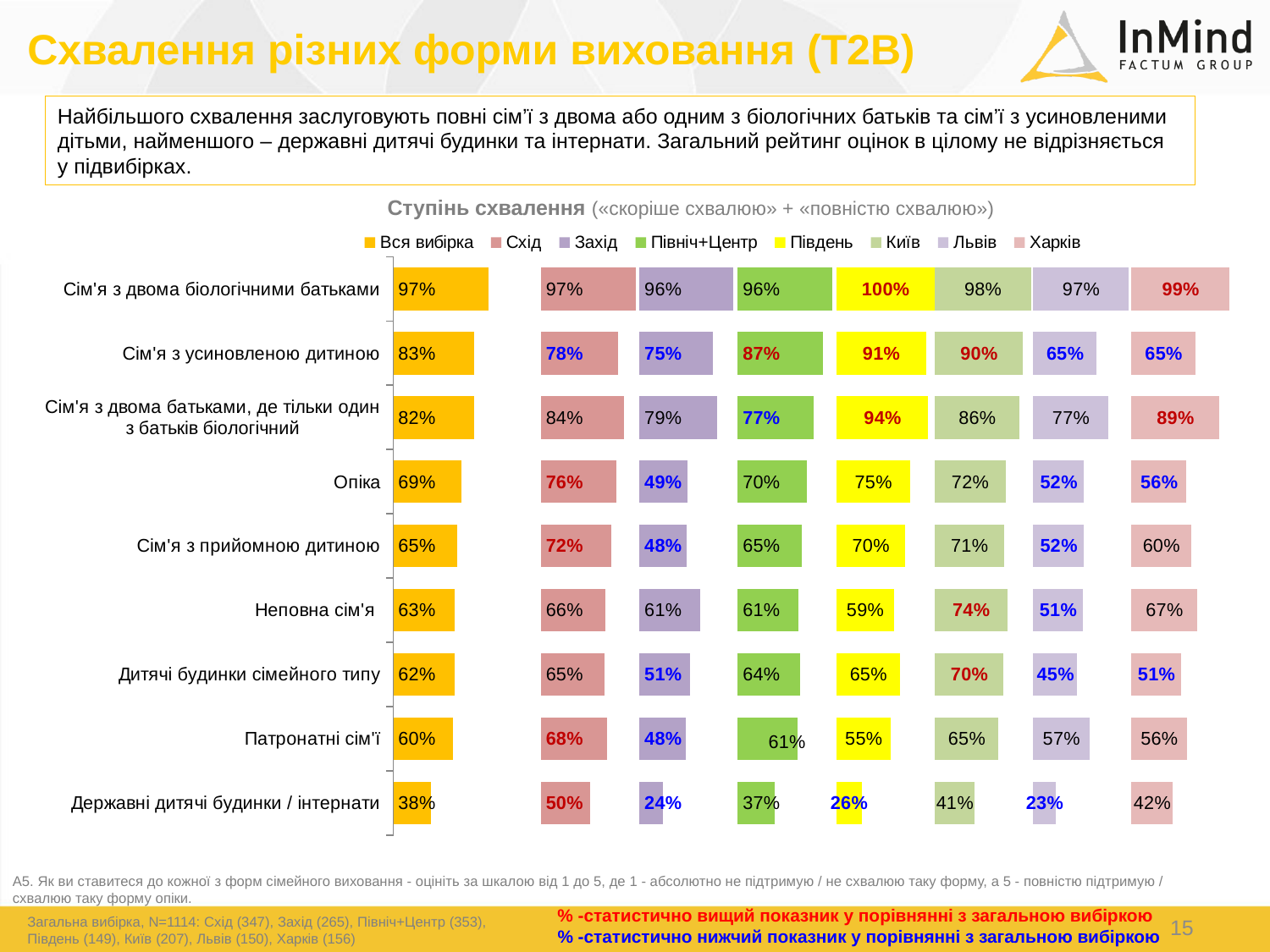
Which category has the highest value for «Вся вибірка»? Сім'я з двома біологічними батьками Which is larger for «Неповна сім'я»: the value for «Київ» or the value for «Львів»? Київ Which category has the lowest value for «Вся вибірка»? Державні дитячі будинки / інтернати How many series does the legend list? 8 How many categories (forms of upbringing) are shown in the chart? 9 What is the value for «Південь» for «Сім'я з двома біологічними батьками»? 100% Which series in the legend is shown in yellow? Південь What is the value for «Львів» for «Державні дитячі будинки / інтернати»? 23% What kind of chart is shown on the slide? Bar chart What is the value for «Вся вибірка» for «Сім'я з усиновленою дитиною»? 83% What is the difference between the «Схід» and «Захід» values for «Опіка»? 27 percentage points What is the difference between the «Вся вибірка» values for «Сім'я з двома біологічними батьками» and «Державні дитячі будинки / інтернати»? 59 percentage points